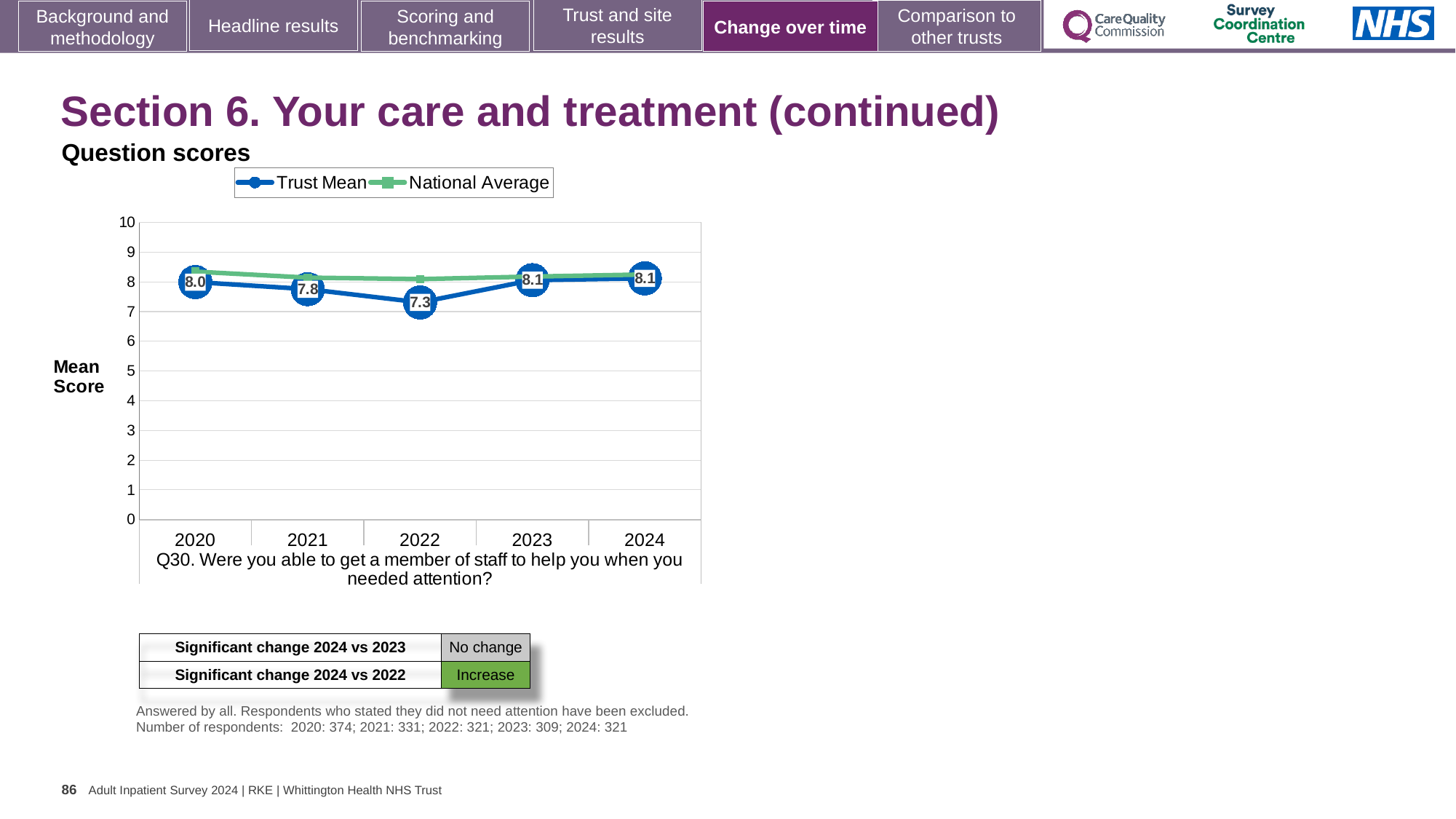
What is the Trust Mean score for 2020? 8.0 What is the Trust Mean score for 2022? 7.3 Does the Trust Mean score rise or fall from 2022 to 2023? rise In which year is the Trust Mean score lowest? 2022 What is the Trust Mean score for 2024? 8.1 Is the National Average value for 2020 greater or less than 8? greater What is the label on the y axis of the chart? Mean Score How many series does the chart legend list? 2 What kind of chart is shown on the slide? line chart Which year has the higher Trust Mean score, 2021 or 2022? 2021 How many years are shown on the x axis of the chart? 5 What is the difference between the Trust Mean scores for 2023 and 2022? 0.8